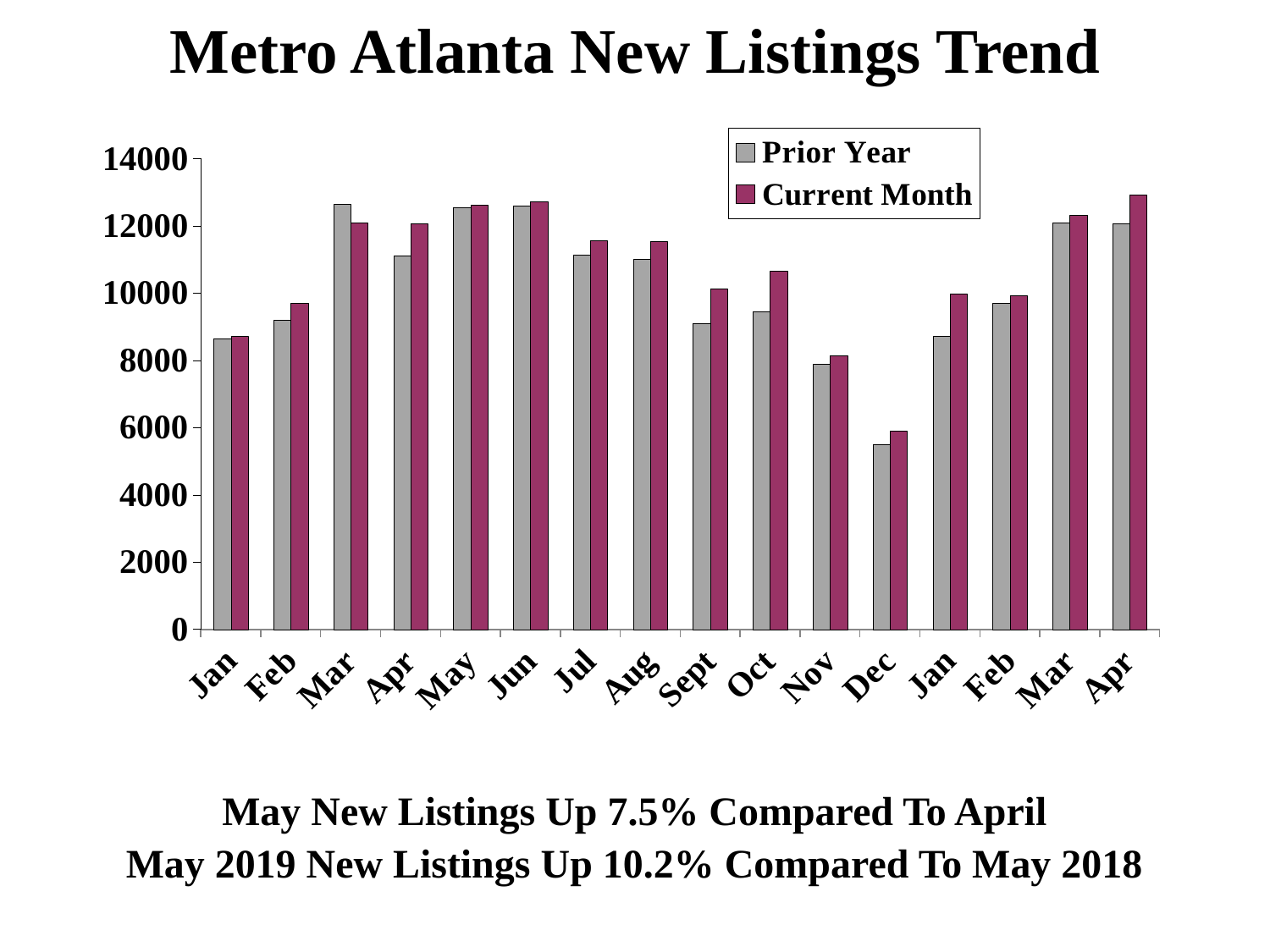
Which month has the lowest Prior Year value? Dec For the first Mar on the axis, which is larger: the Prior Year value or the Current Month value? Prior Year How many series does the legend list? 2 Is the Current Month value for Oct greater or less than 10000? greater Is the Prior Year value for Dec greater or less than 6000? less For Sept, which is larger: the Prior Year value or the Current Month value? Current Month Which month has the lowest Current Month value? Dec What are the two series named in the legend? Prior Year and Current Month What kind of chart is shown on the slide? Bar chart Is the Prior Year value for the first Feb on the axis greater or less than 10000? less How many month categories are shown along the x axis? 16